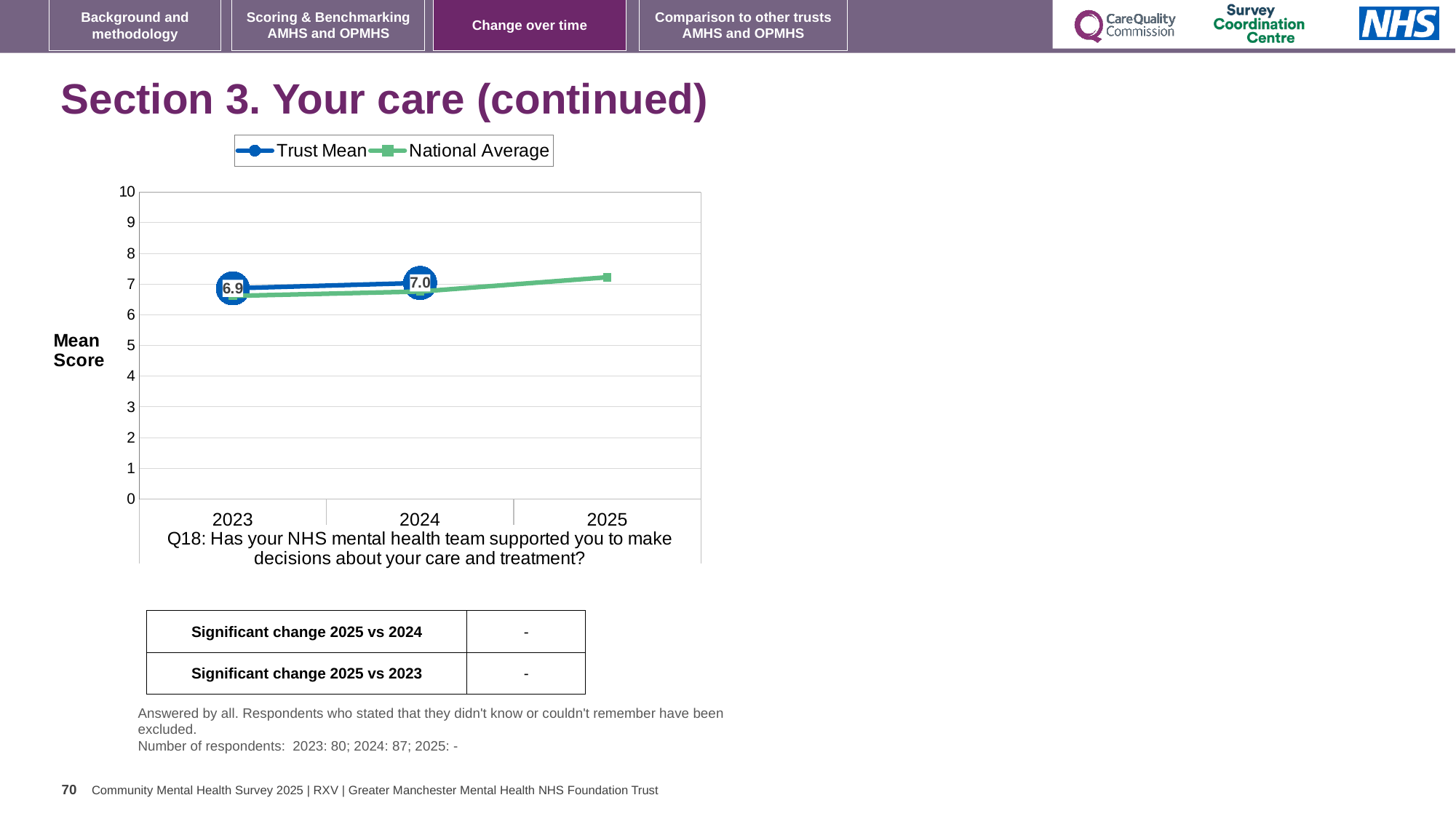
Which is larger, the Trust Mean score for 2024 or for 2023? 2024 Is the National Average value for 2023 greater or less than 7? less Does the Trust Mean score rise or fall from 2023 to 2024? rise What is the Trust Mean score for 2024? 7.0 What is the Trust Mean score for 2023? 6.9 In which year is the Trust Mean score lowest? 2023 Is the National Average value for 2025 greater or less than 6? greater How many years are shown on the x axis of the chart? 3 What kind of chart is shown on the slide? line chart In which year is the Trust Mean score highest? 2024 What is the difference between the Trust Mean scores for 2024 and 2023? 0.1 How many series does the chart legend list? 2